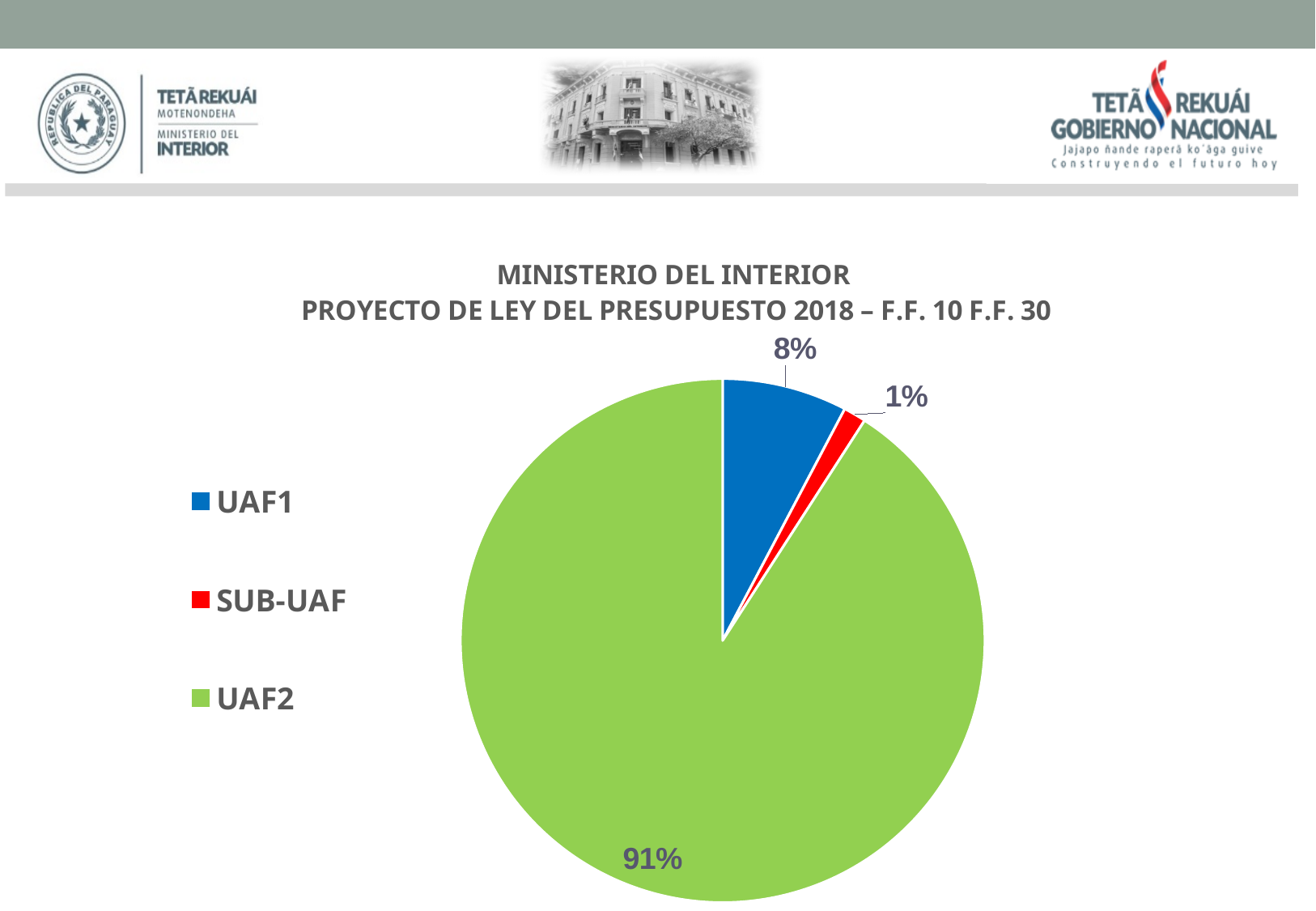
How many categories does the pie chart show? 3 Which is larger, the UAF1 slice or the SUB-UAF slice? UAF1 What colour is the UAF2 slice in the pie chart? Green Which category has the smallest slice of the pie? SUB-UAF Which category has the largest slice of the pie? UAF2 What share of the pie does UAF2 represent? 91% What share of the pie does UAF1 represent? 8% What share of the pie does SUB-UAF represent? 1% What is the difference in percentage points between the UAF1 and SUB-UAF slices? 7 What is the difference in percentage points between the UAF2 and UAF1 slices? 83 Which legend entry is shown in red? SUB-UAF What kind of chart is shown on the slide? Pie chart